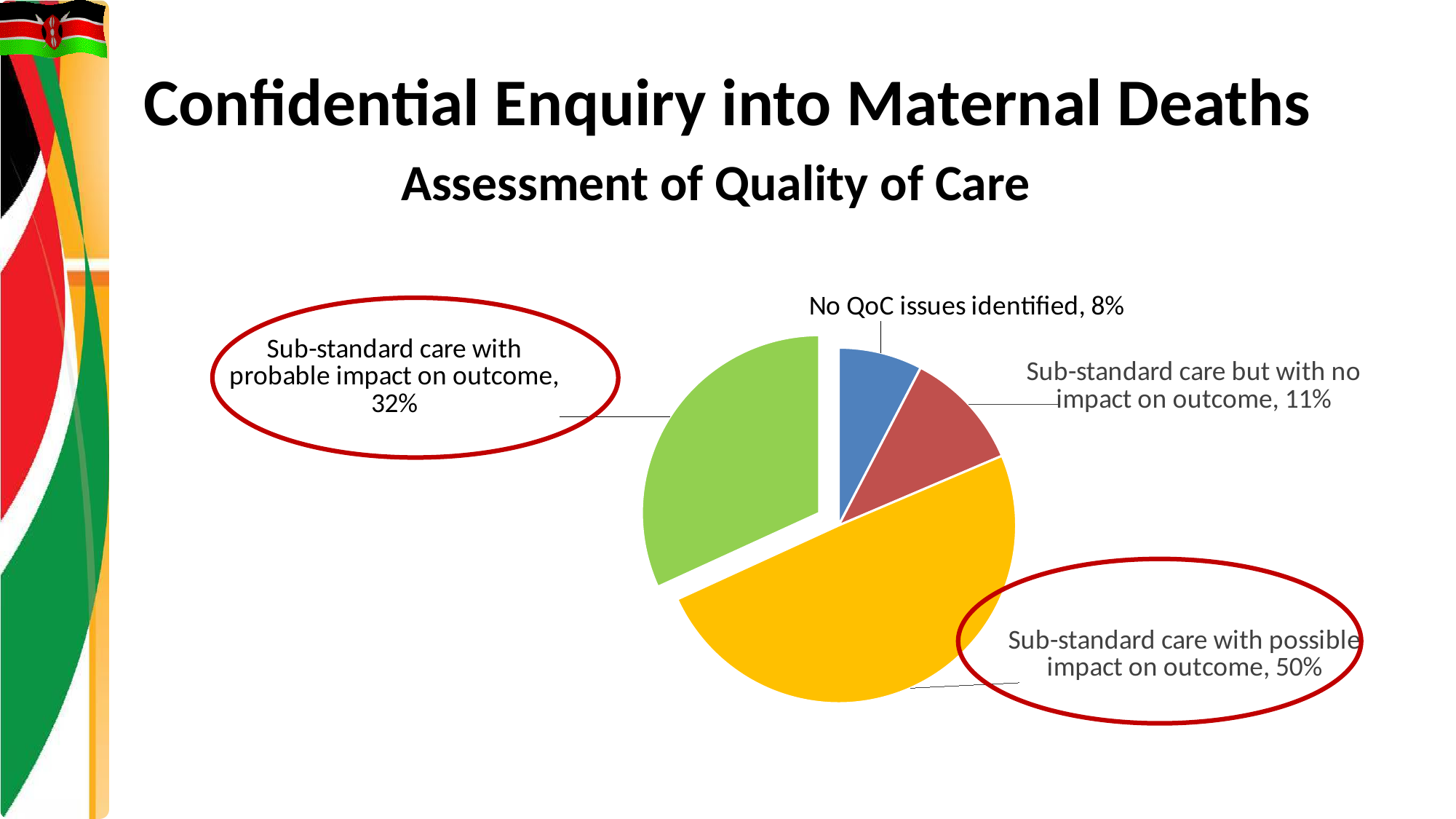
Which category has the largest slice of the pie? Sub-standard care with possible impact on outcome Which category has the smallest slice of the pie? No QoC issues identified How many slices does the pie chart have? 4 What share of the pie is 'Sub-standard care with probable impact on outcome'? 32% What is the difference in percentage points between 'Sub-standard care with possible impact on outcome' and 'Sub-standard care with probable impact on outcome'? 18 What share of the pie is 'No QoC issues identified'? 8% What share of the pie is 'Sub-standard care with possible impact on outcome'? 50% What kind of chart is shown on the slide? pie chart Which is larger: 'Sub-standard care but with no impact on outcome' or 'No QoC issues identified'? Sub-standard care but with no impact on outcome Which two slices are highlighted with red ovals around their labels? Sub-standard care with probable impact on outcome and Sub-standard care with possible impact on outcome What colour is the slice for 'Sub-standard care with possible impact on outcome'? yellow